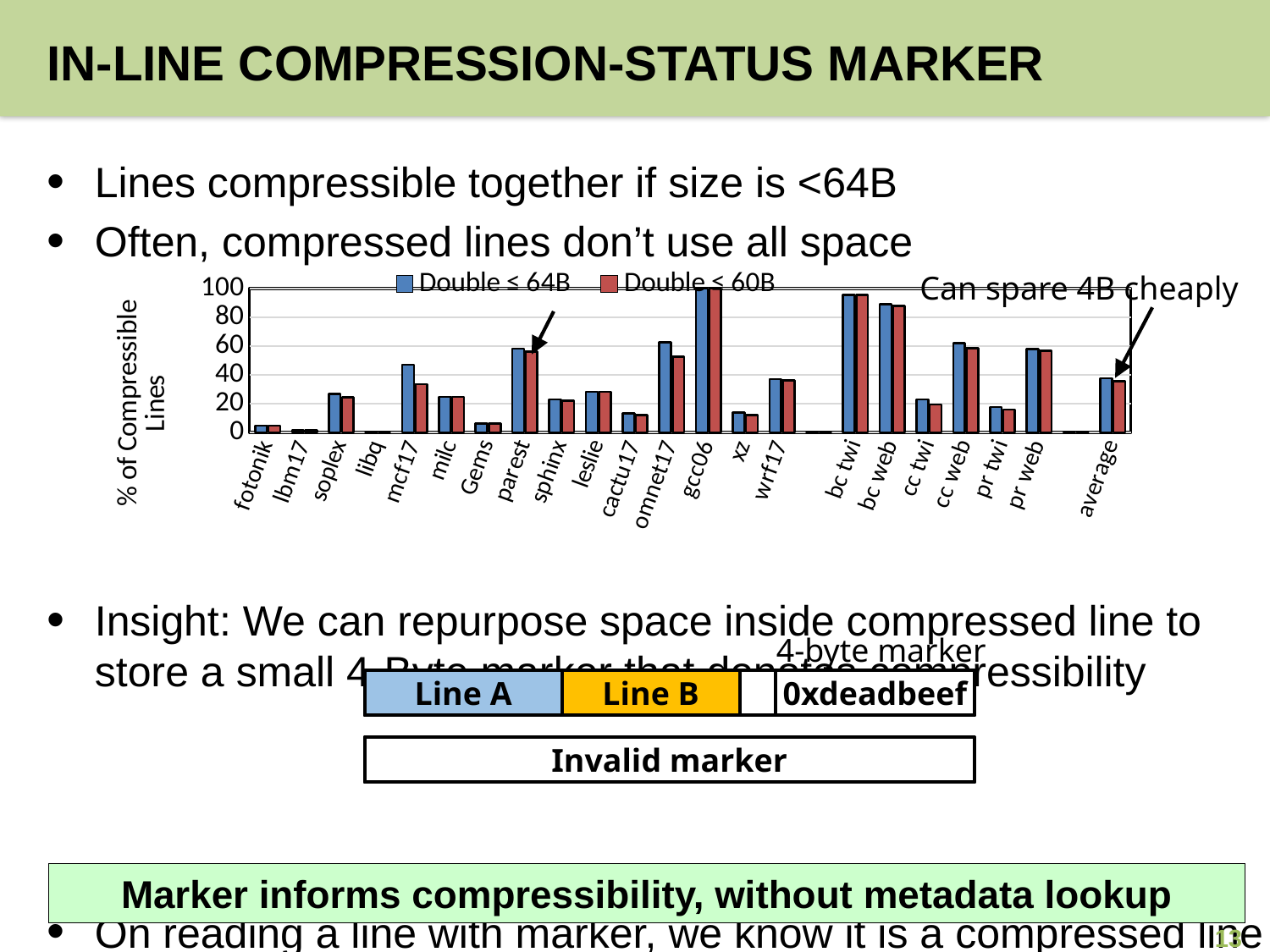
What is the label on the chart's vertical axis? % of Compressible Lines How many series does the chart's legend list? 2 Which has a larger Double ≤ 64B value, parest or sphinx? parest Which has a larger Double ≤ 60B value, bc web or cc twi? bc web What kind of chart is shown on the slide? bar chart Is the Double ≤ 64B value for bc twi greater or less than 80? greater Is the Double ≤ 64B value for gcc06 greater or less than 80? greater Is the Double ≤ 60B value for average greater or less than 60? less What are the two series named in the chart's legend? Double ≤ 64B and Double ≤ 60B Which category has the highest value for Double ≤ 64B? gcc06 Which has a larger Double ≤ 64B value, gcc06 or xz? gcc06